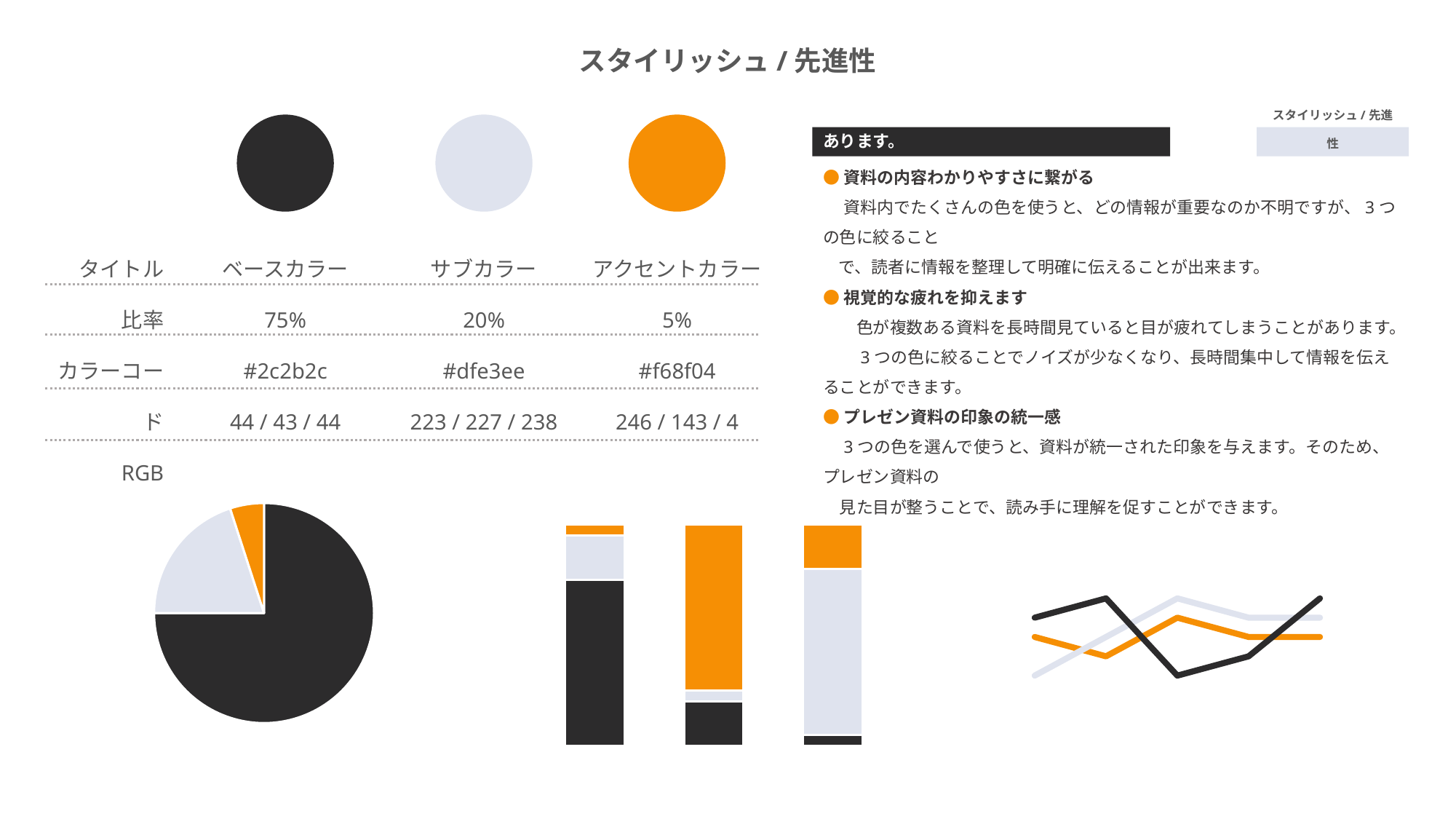
Which three colours are used in the charts on the slide? Black, light grey and orange In the stacked bar chart at the bottom middle, which bar has the largest dark (black) segment? The left bar What kind of chart is shown at the bottom left of the slide? Pie chart What kind of chart is shown at the bottom right of the slide? Line chart What kind of chart is shown at the bottom middle of the slide? Bar chart In the pie chart at the bottom left, which colour slice is the smallest? The orange slice How many slices does the pie chart at the bottom left have? 3 In the pie chart at the bottom left, which colour slice is the largest? The dark (black) slice How many lines are plotted in the line chart at the bottom right? 3 In the stacked bar chart at the bottom middle, which bar has the largest orange segment? The middle bar How many bars does the stacked bar chart at the bottom middle have? 3 In the stacked bar chart at the bottom middle, which bar has the largest light grey segment? The right bar